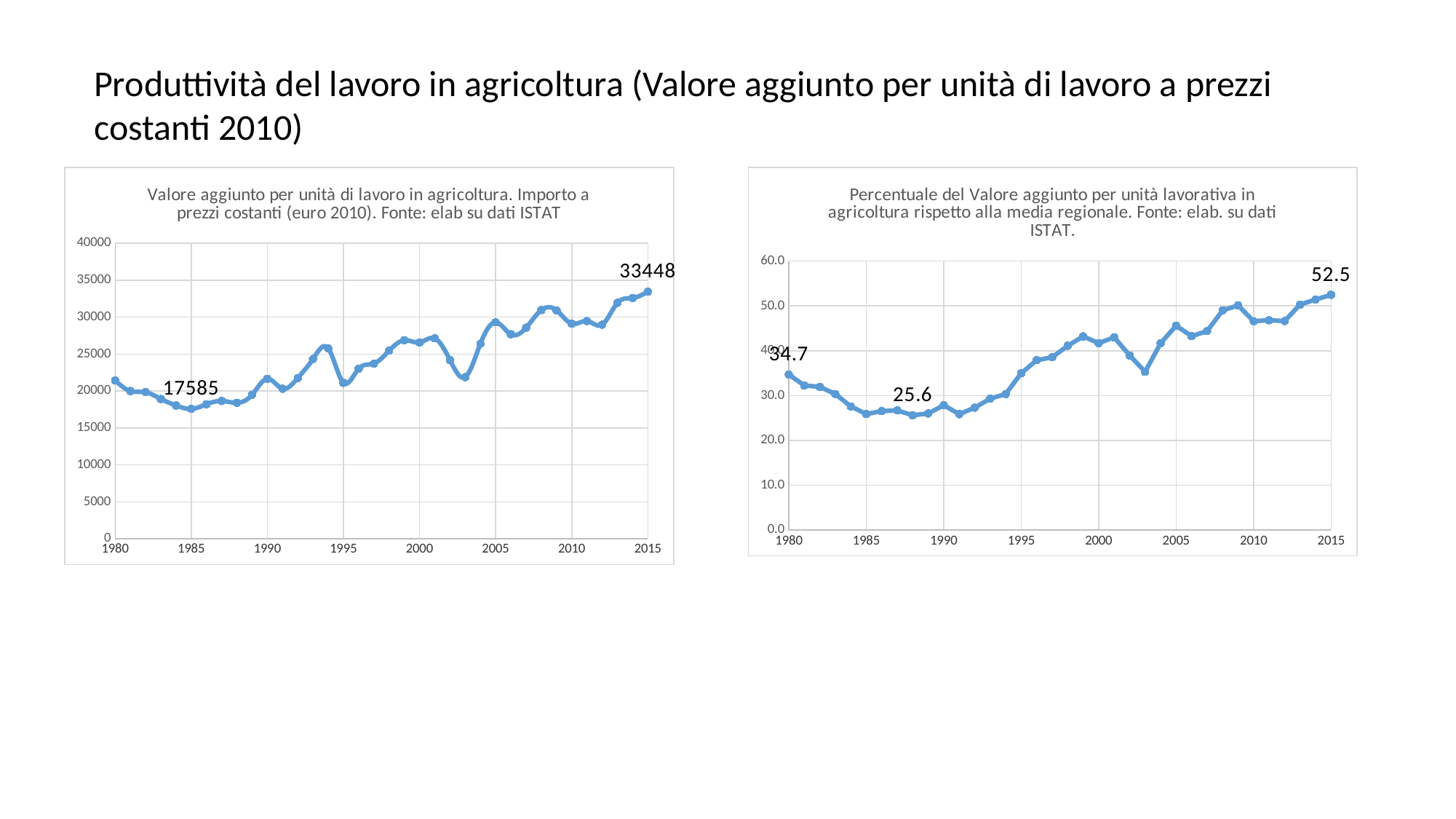
In the left chart (Valore aggiunto per unità di lavoro in agricoltura), which year has the highest value? 2015 In the left chart (Valore aggiunto per unità di lavoro in agricoltura), is the value for 1980 greater or less than 20000? greater In the right chart (Percentuale del Valore aggiunto per unità lavorativa), what is the value labelled for 1980? 34.7 In the left chart (Valore aggiunto per unità di lavoro in agricoltura), what is the difference between the labelled 2015 value and the labelled 1985 value? 15863 In the right chart (Percentuale del Valore aggiunto per unità lavorativa), does the value overall rise or fall from 1990 to 2015? Rise In the left chart (Valore aggiunto per unità di lavoro in agricoltura), what is the value labelled at the low point around 1985? 17585 What kind of chart is the left chart (Valore aggiunto per unità di lavoro in agricoltura)? Line chart In the left chart (Valore aggiunto per unità di lavoro in agricoltura), what is the value labelled for 2015? 33448 In the right chart (Percentuale del Valore aggiunto per unità lavorativa), is the value for 2005 greater or less than 40.0? greater In the right chart (Percentuale del Valore aggiunto per unità lavorativa), what is the difference between the labelled 2015 value and the labelled 1980 value? 17.8 In the right chart (Percentuale del Valore aggiunto per unità lavorativa), what is the value labelled for 2015? 52.5 In the left chart (Valore aggiunto per unità di lavoro in agricoltura), is the value for 1995 greater or less than 25000? less